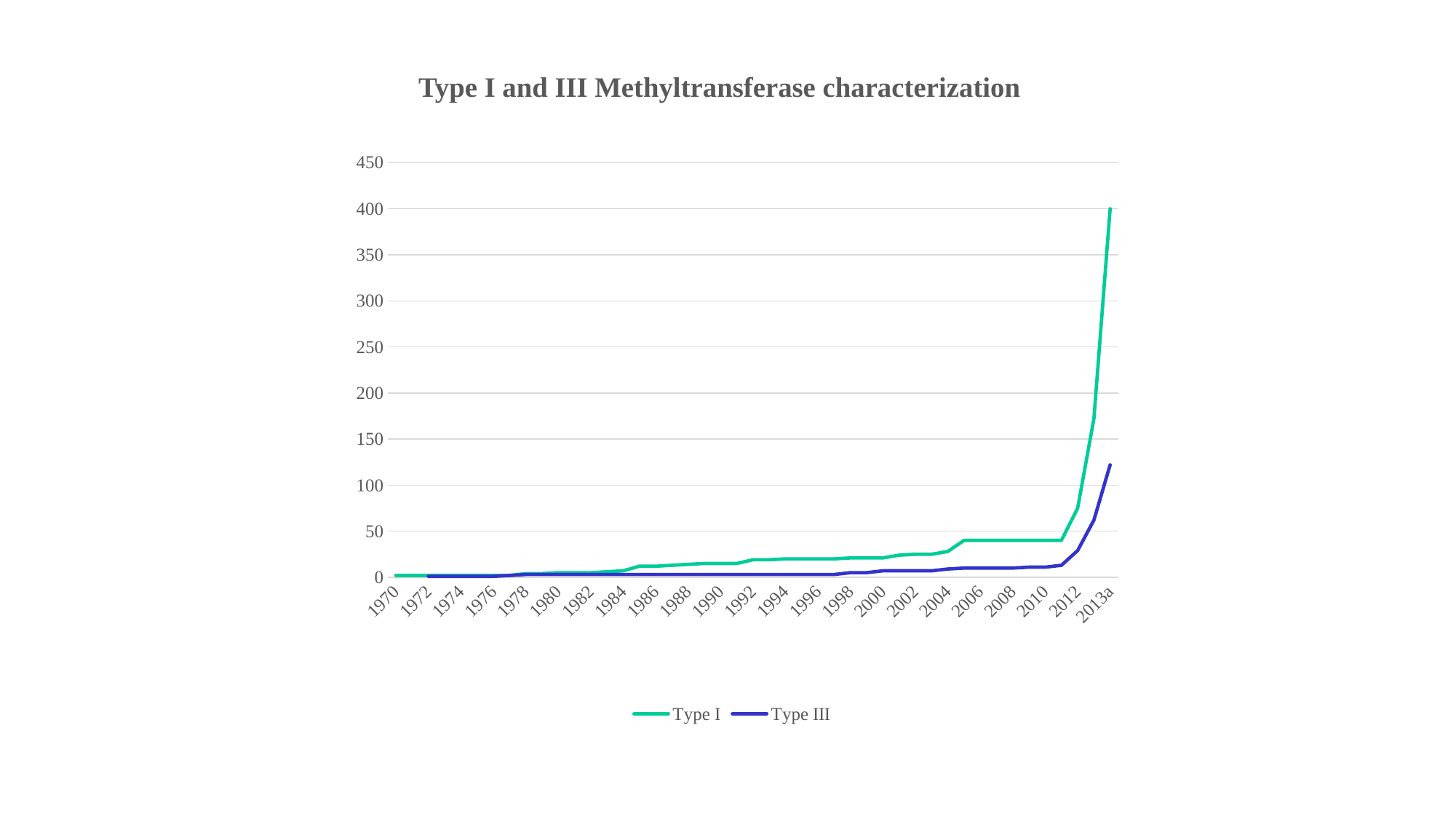
Which series has the highest value anywhere on the chart? Type I Is the value for Type III at 2012 greater or less than 50? less Is the value for Type I at 2008 greater or less than 50? less Do the values for Type I generally rise or fall from 1970 to 2013a? rise What kind of chart is shown on the slide? line chart Which series is drawn in green? Type I Is the value for Type III at 2000 greater or less than 50? less How many series does the legend list? 2 What is the title of the chart? Type I and III Methyltransferase characterization Which series reaches the higher value at 2013a, Type I or Type III? Type I